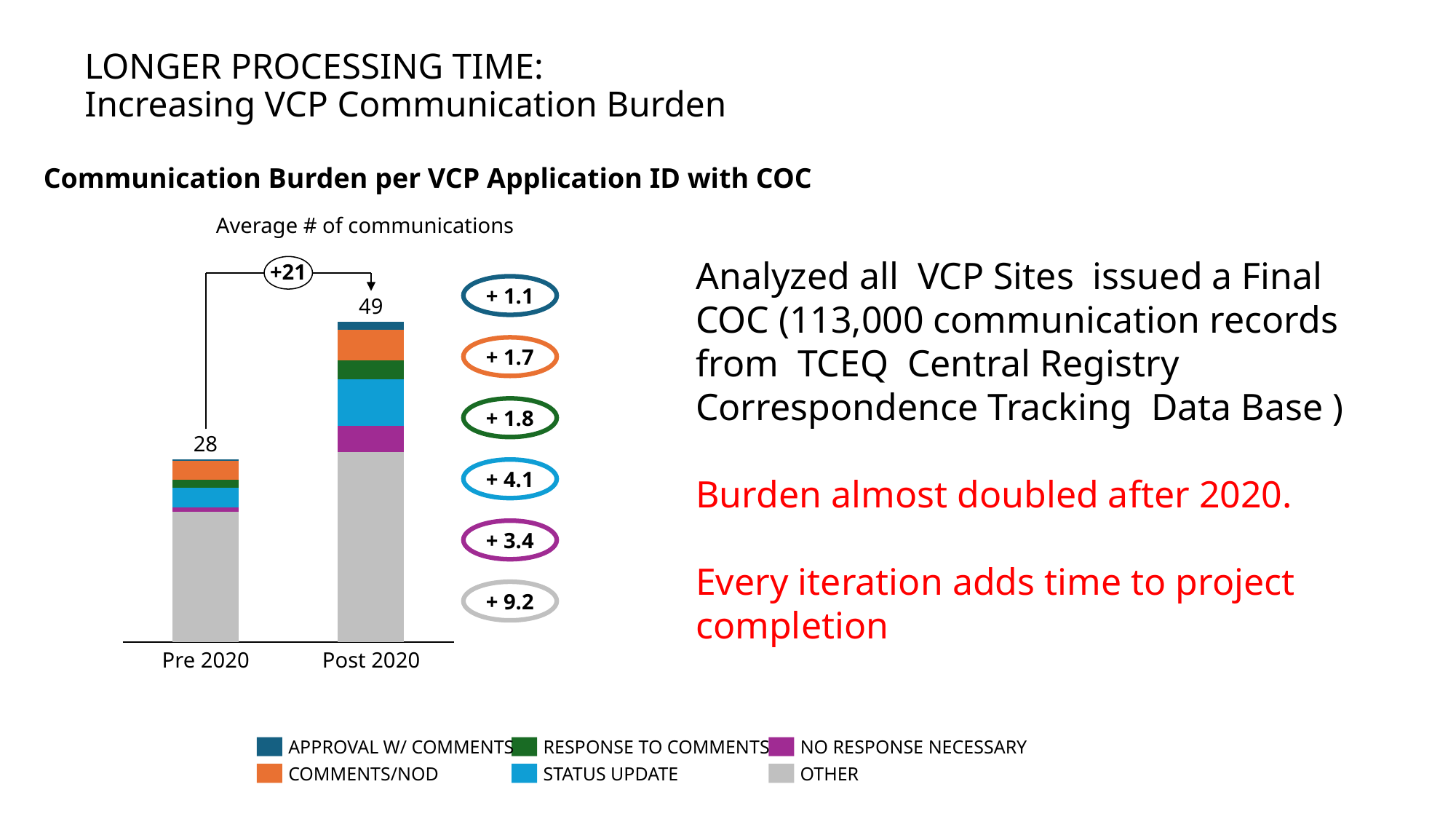
By how much did the total average number of communications increase from Pre 2020 to Post 2020? +21 What kind of chart is shown on the slide? Stacked bar chart What is the increase shown for the STATUS UPDATE series? + 4.1 Which series shows the largest increase between Pre 2020 and Post 2020? OTHER What is the title of the chart? Communication Burden per VCP Application ID with COC How many categories are shown on the x axis? 2 Do the total values rise or fall from Pre 2020 to Post 2020? Rise What is the increase shown for the OTHER series? + 9.2 Which category has the higher total, Pre 2020 or Post 2020? Post 2020 What is the total average number of communications for Post 2020? 49 How many series does the legend list? 6 What is the total average number of communications for Pre 2020? 28